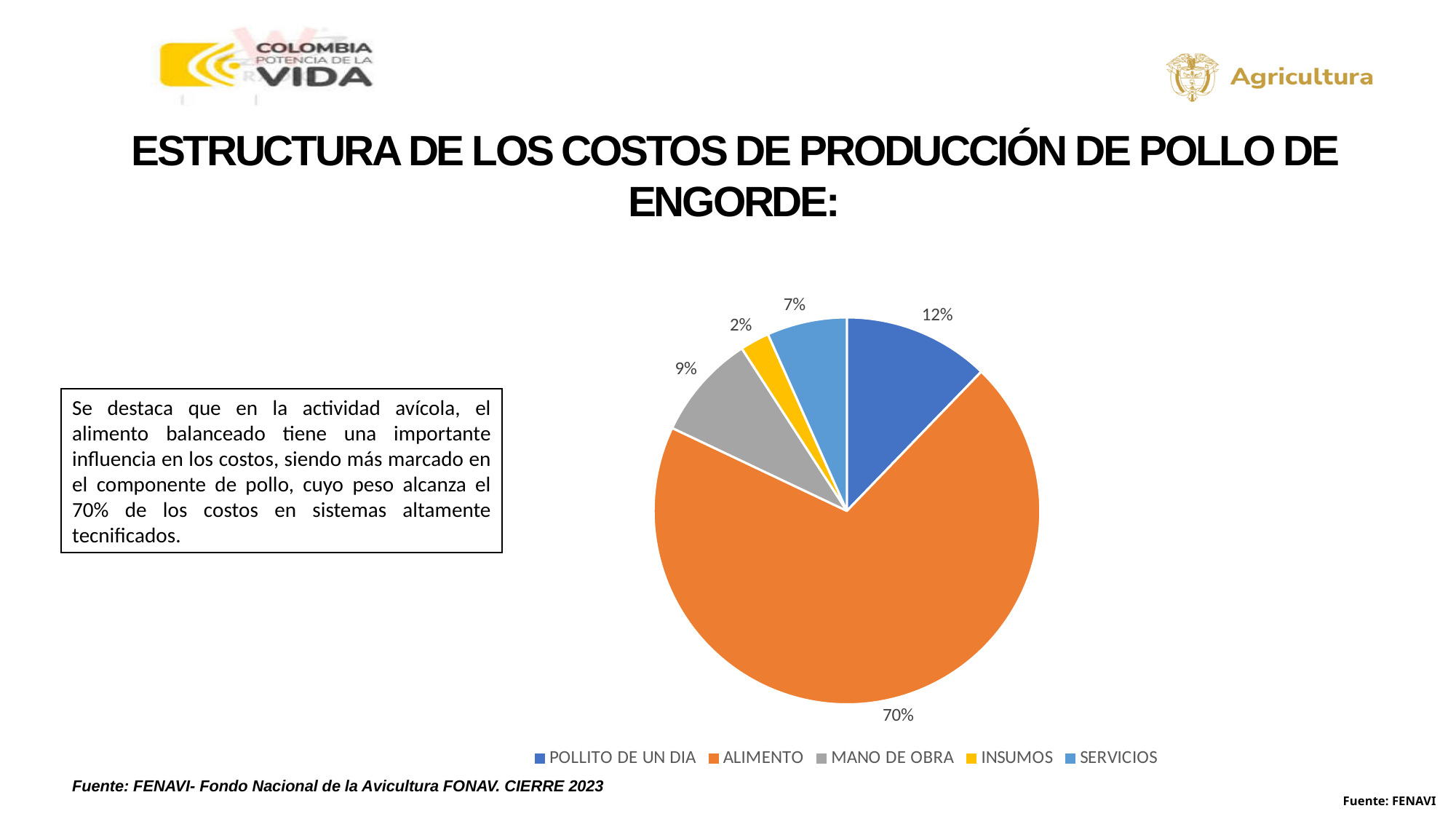
Which category has the smallest slice of the pie? INSUMOS What kind of chart is shown on the slide? pie chart What share of the pie does ALIMENTO represent? 70% What share of the pie does SERVICIOS represent? 7% What share of the pie does MANO DE OBRA represent? 9% Which is larger, the share for MANO DE OBRA or the share for SERVICIOS? MANO DE OBRA Which category has the largest slice of the pie? ALIMENTO What colour is the ALIMENTO slice in the pie chart? orange What is the difference in percentage points between ALIMENTO and POLLITO DE UN DIA? 58 How many categories does the pie chart have? 5